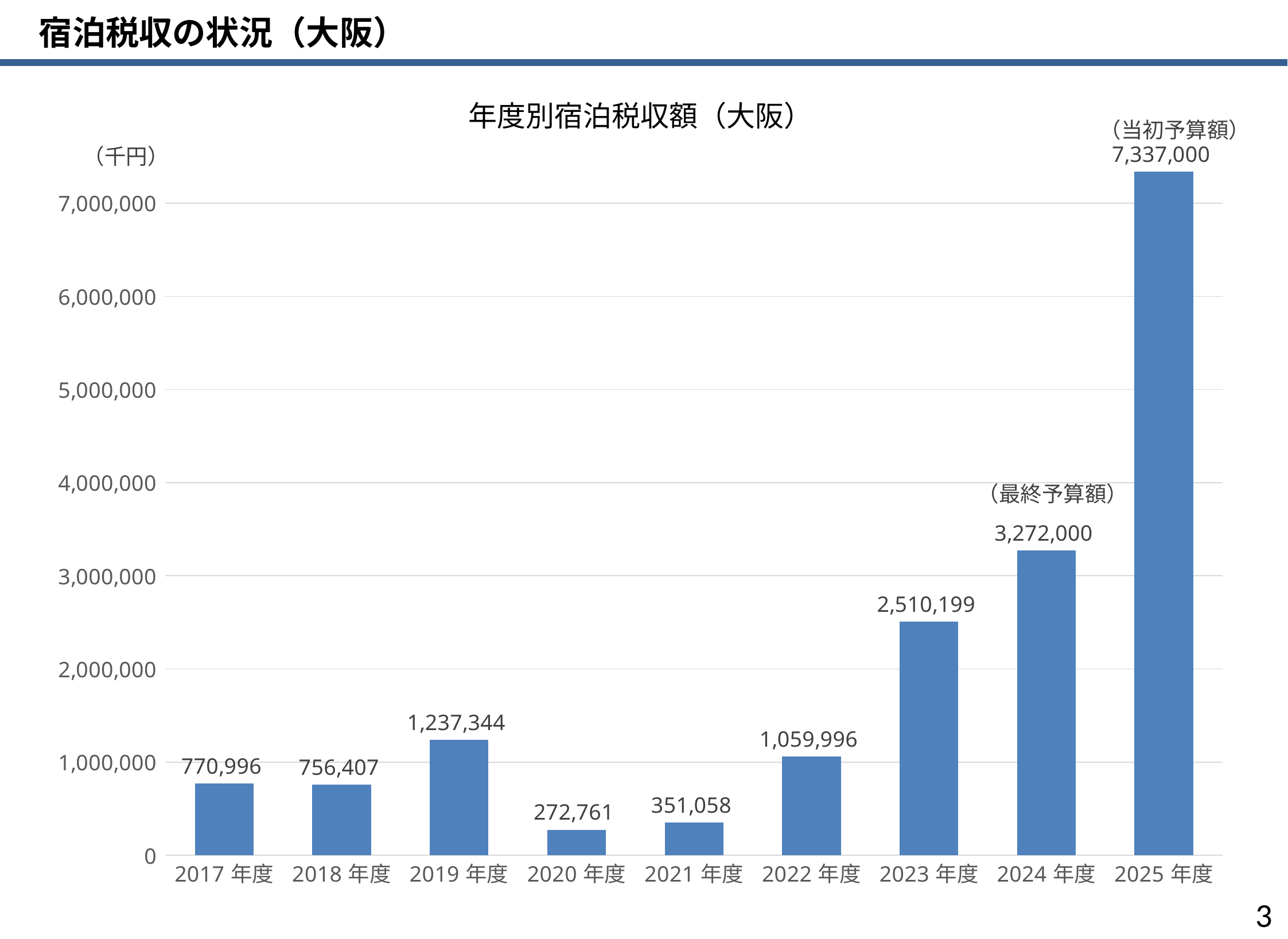
What kind of chart is shown on the slide? bar chart Is the value for 2023年度 greater or less than 2,000,000? greater How many fiscal years are shown on the x axis? 9 What is the difference between the values for 2025年度 and 2024年度? 4,065,000 What is the difference between the values for 2017年度 and 2018年度? 14,589 Which fiscal year has the highest value? 2025年度 What is the value for 2019年度? 1,237,344 Which fiscal year has the lowest value? 2020年度 Which is larger, the value for 2022年度 or the value for 2019年度? 2019年度 What is the value for 2020年度? 272,761 What is the value for 2024年度 (最終予算額)? 3,272,000 What is the title of the chart? 年度別宿泊税収額（大阪）